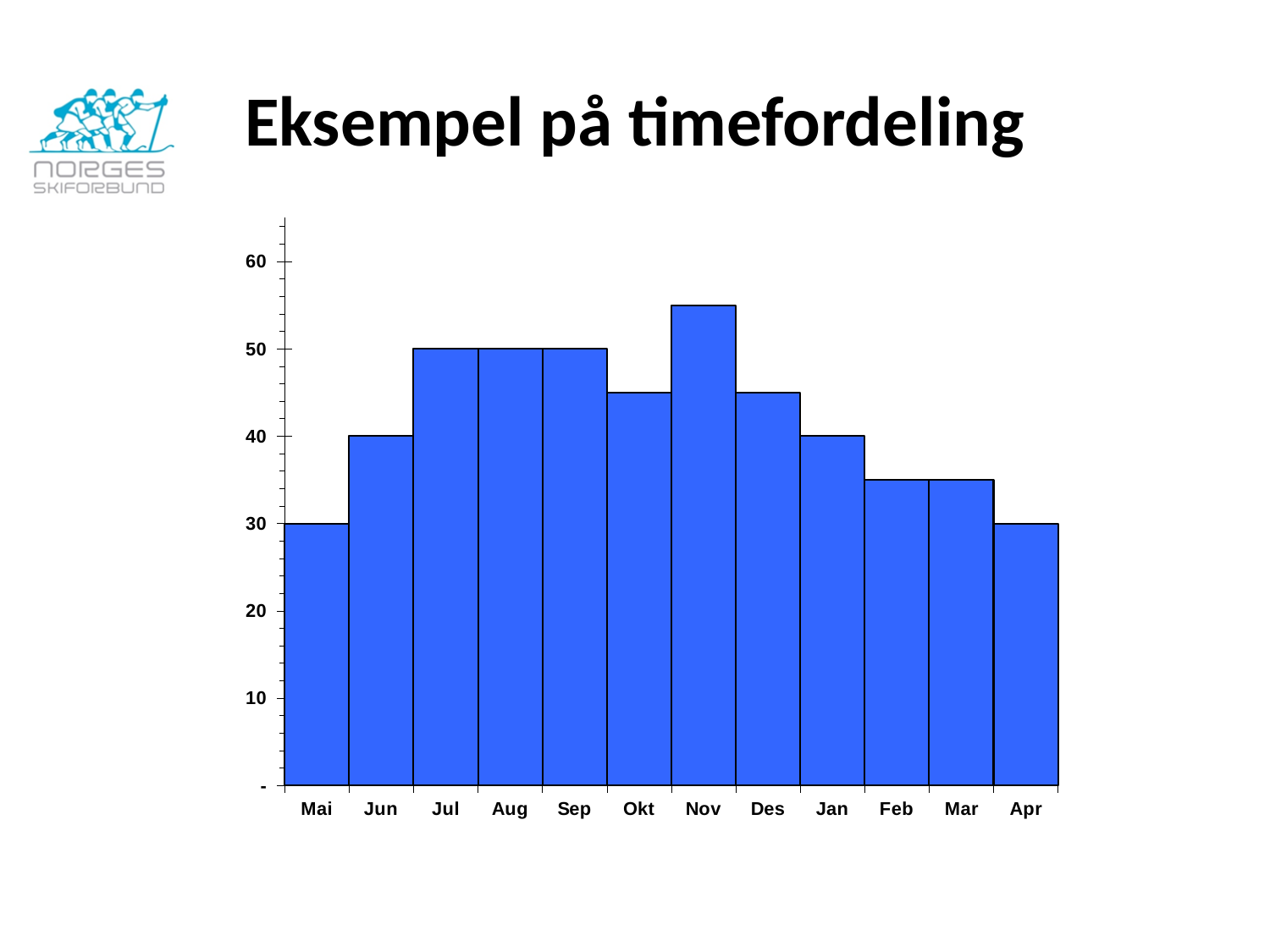
What is the value for Jan? 40 Which month has the highest bar? Nov Is the value for Feb greater or less than 40? less What is the title of the slide? Eksempel på timefordeling What is the value for Jul? 50 What is the difference between the values for Jul and Mai? 20 How many months are shown on the x axis? 12 Is the value for Nov greater or less than 50? greater What kind of chart is shown on the slide? bar chart What is the value for Jun? 40 What is the value for Mai? 30 Which is larger, the value for Jul or the value for Jun? Jul